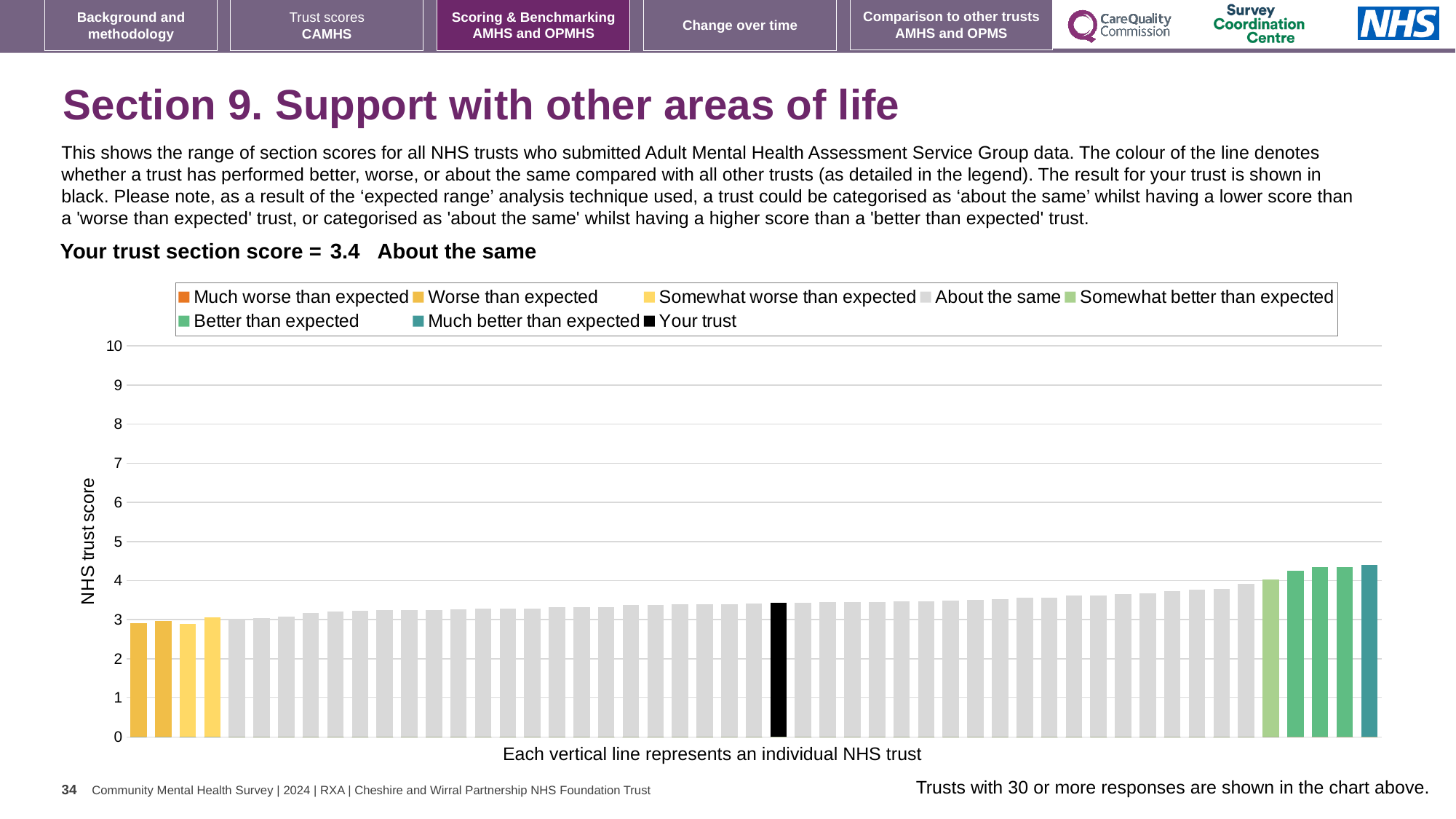
How many entries does the chart legend list? 8 Which is larger: the black 'Your trust' bar or the leftmost bar? Your trust What kind of chart is shown on the slide? bar chart Is the value of the black 'Your trust' bar greater or less than 4? less Is the value of the tallest bar greater or less than 5? less How many bars are coloured as 'Much better than expected' (teal)? 1 Is the value of the tallest bar (Much better than expected) greater or less than 4? greater What is the label on the y axis of the chart? NHS trust score Do the bar values rise or fall from left to right along the x axis? rise How many bars are coloured as 'Better than expected' (green)? 3 What is the section score for your trust shown on the slide? 3.4 How many bars are coloured as 'Worse than expected' (orange-yellow)? 2